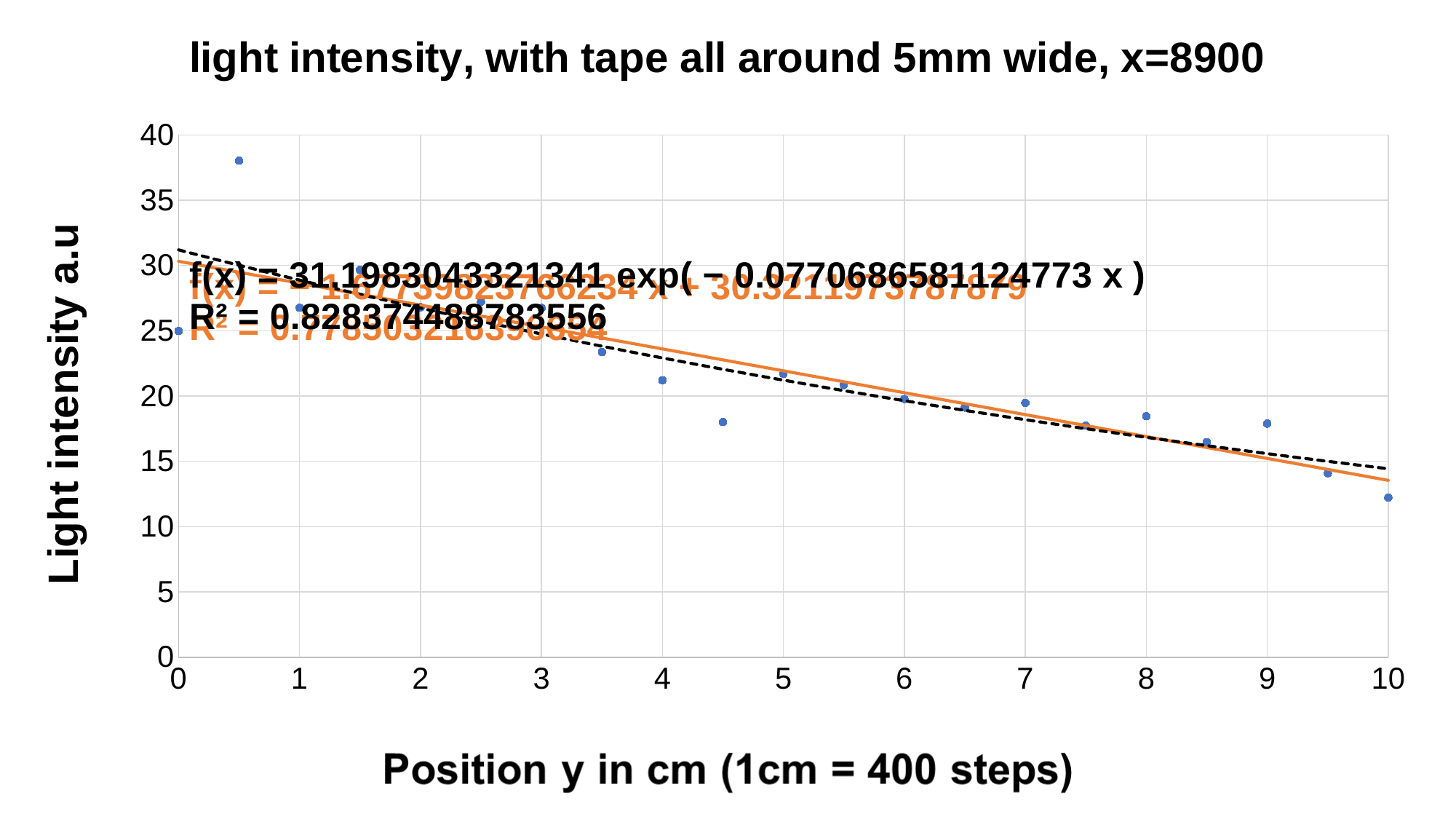
Is the light intensity at position y = 3.5 greater or less than 20? greater Is the light intensity at position y = 0.5 greater or less than 35? greater What is the label of the x axis? Position y in cm (1cm = 400 steps) At which position y is the light intensity lowest? 10 Do the light intensity values generally rise or fall as position y increases? fall Which has the higher light intensity: position y = 4 or position y = 4.5? 4 Is the light intensity at position y = 10 greater or less than 15? less What kind of chart is shown on the slide? scatter chart At which position y is the light intensity highest? 0.5 Which has the higher light intensity: position y = 9.5 or position y = 10? 9.5 What is the title of the chart? light intensity, with tape all around 5mm wide, x=8900